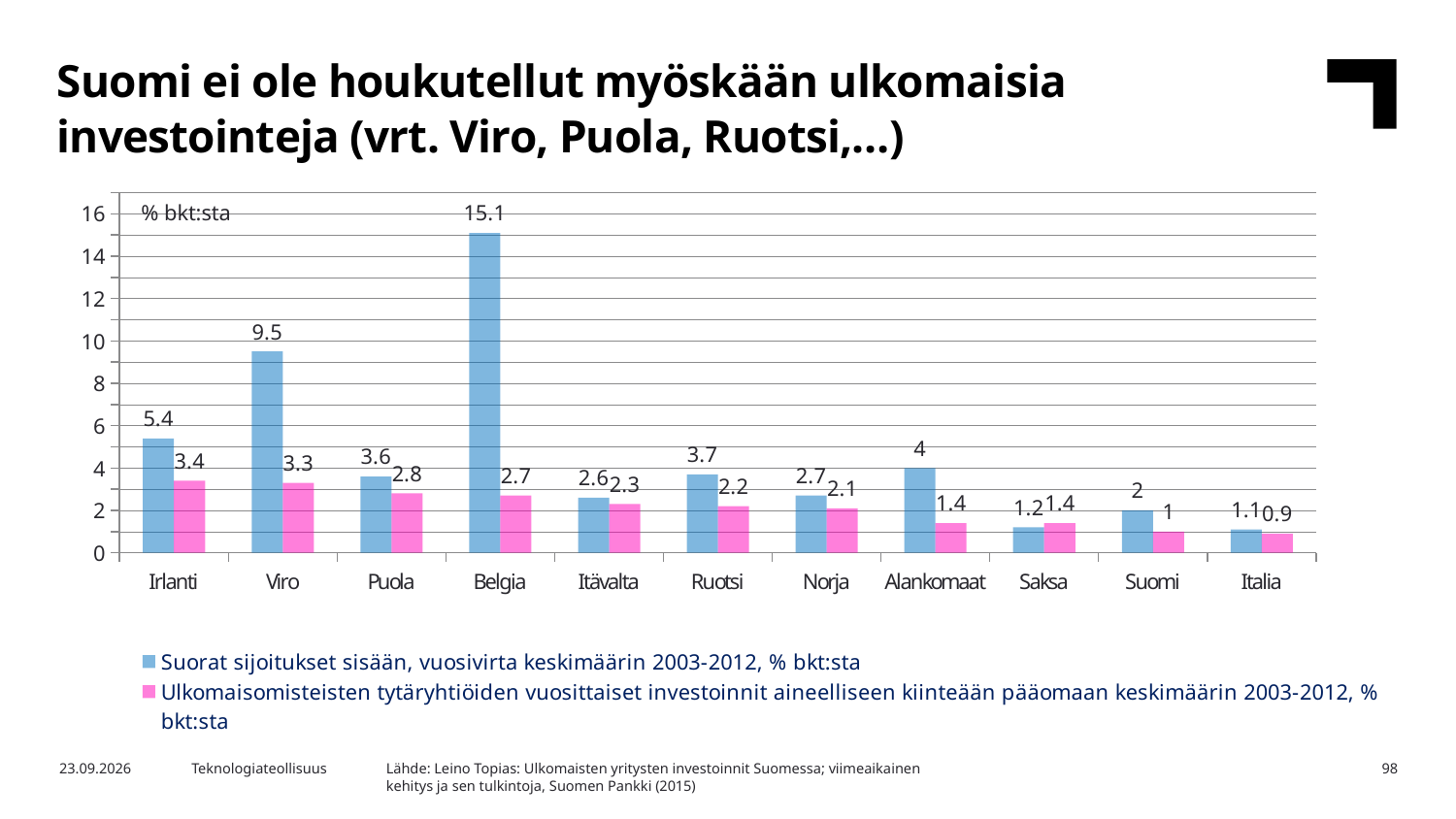
What is the value of the pink series (Ulkomaisomisteisten tytäryhtiöiden vuosittaiset investoinnit) for Suomi? 1 Which is larger: the blue series value for Suomi or the blue series value for Ruotsi? Ruotsi What kind of chart is shown on the slide? bar chart Is the blue series value for Irlanti greater or less than 4? greater What unit label is shown at the top left of the chart's plot area? % bkt:sta What is the value of the blue series (Suorat sijoitukset sisään) for Belgia? 15.1 What is the value of the blue series (Suorat sijoitukset sisään) for Viro? 9.5 How many countries are shown on the x axis of the chart? 11 Which country has the lowest value in the pink series (Ulkomaisomisteisten tytäryhtiöiden vuosittaiset investoinnit)? Italia What is the difference between the blue series values for Belgia and Viro? 5.6 How many series does the legend list? 2 Which country has the highest value in the blue series (Suorat sijoitukset sisään)? Belgia